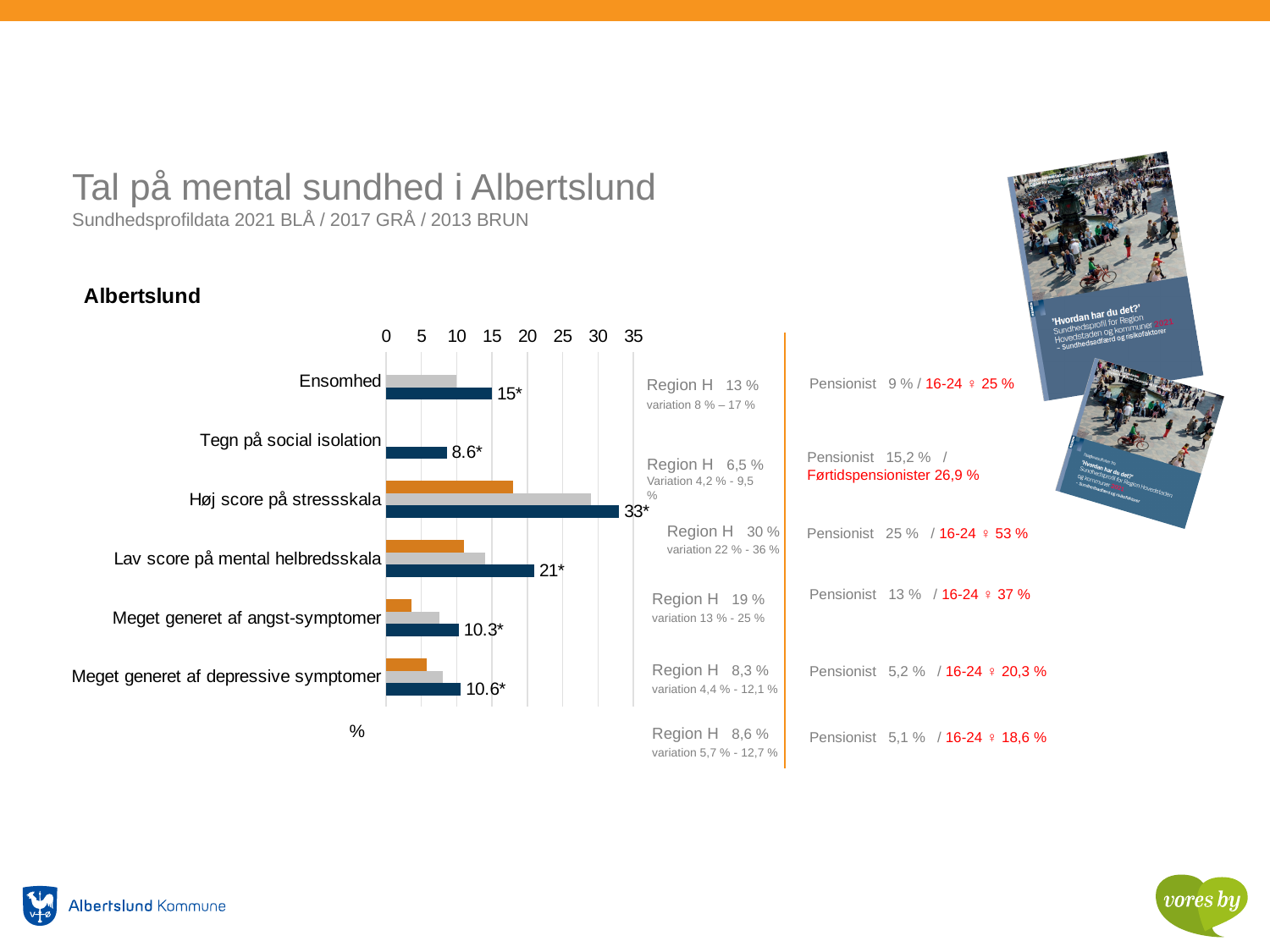
What kind of chart is shown on the slide? Bar chart What is the difference between the 2021 values for Høj score på stressskala and Lav score på mental helbredsskala? 12 According to the subtitle, which colour represents the 2021 data? Blue (BLÅ) Which has the larger 2021 (blue) value: Ensomhed or Lav score på mental helbredsskala? Lav score på mental helbredsskala Is the 2017 (grey) value for Høj score på stressskala greater or less than 25? greater Is the 2017 (grey) value for Ensomhed greater or less than 15? less What is the 2021 (blue) value for Meget generet af angst-symptomer? 10.3* Which category has the lowest 2021 (blue) value? Tegn på social isolation Which category has the highest 2021 (blue) value? Høj score på stressskala How many categories are shown on the chart? 6 What is the 2021 (blue) value for Høj score på stressskala? 33* What is the 2021 (blue) value for Ensomhed? 15*